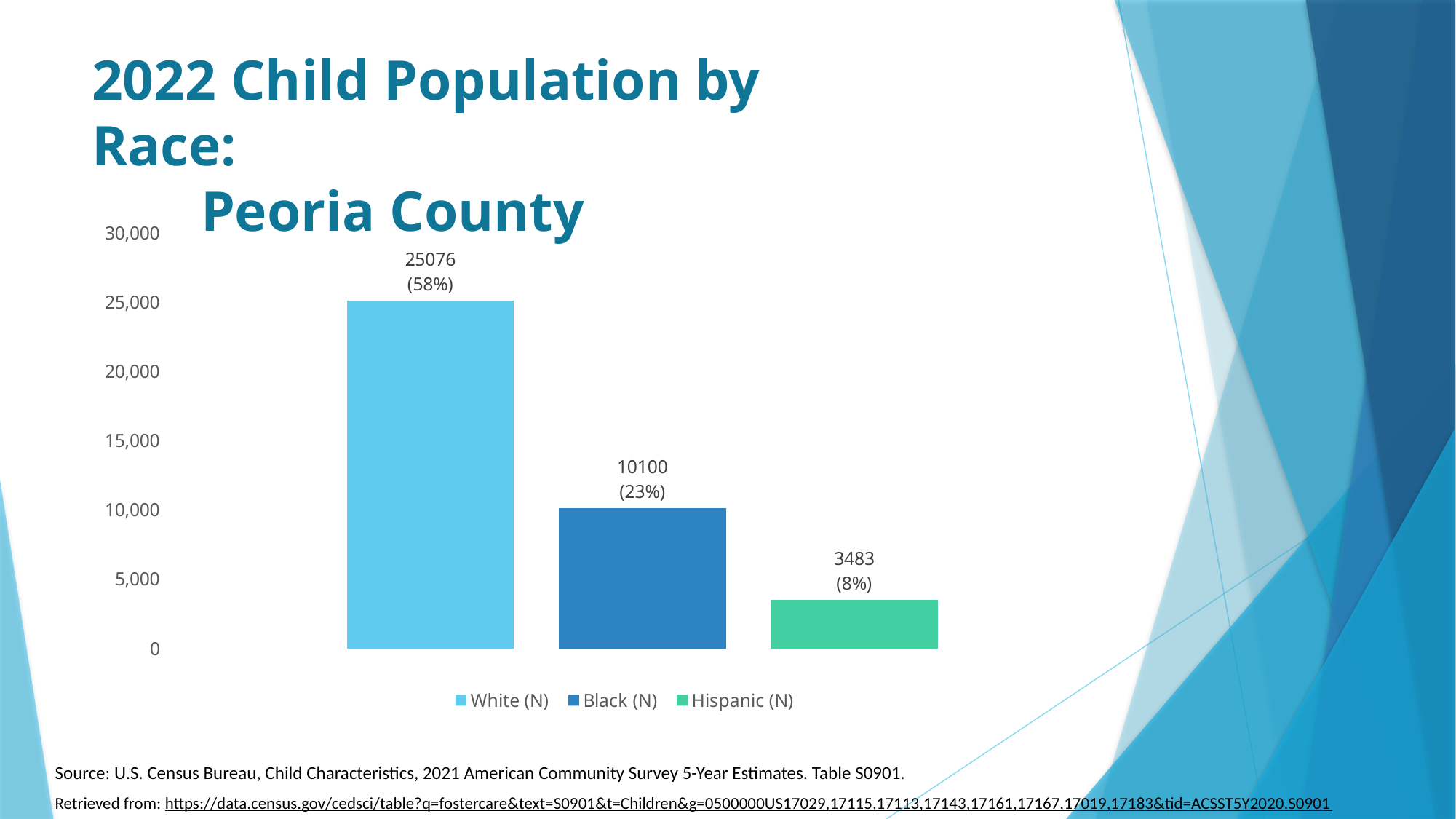
What kind of chart is shown on the slide? bar chart Which group has the highest child population? White (N) What is the title of the chart? 2022 Child Population by Race: Peoria County Which is larger, the value for Black (N) or Hispanic (N)? Black (N) What is the child population value shown for Hispanic (N)? 3483 What percentage is shown for the Black (N) bar? 23% What is the child population value shown for Black (N)? 10100 What is the child population value shown for White (N)? 25076 Which group has the lowest child population? Hispanic (N) Is the value for Hispanic (N) greater or less than 5,000? less How many bars are plotted in the chart? 3 What is the difference between the White (N) and Black (N) values? 14976